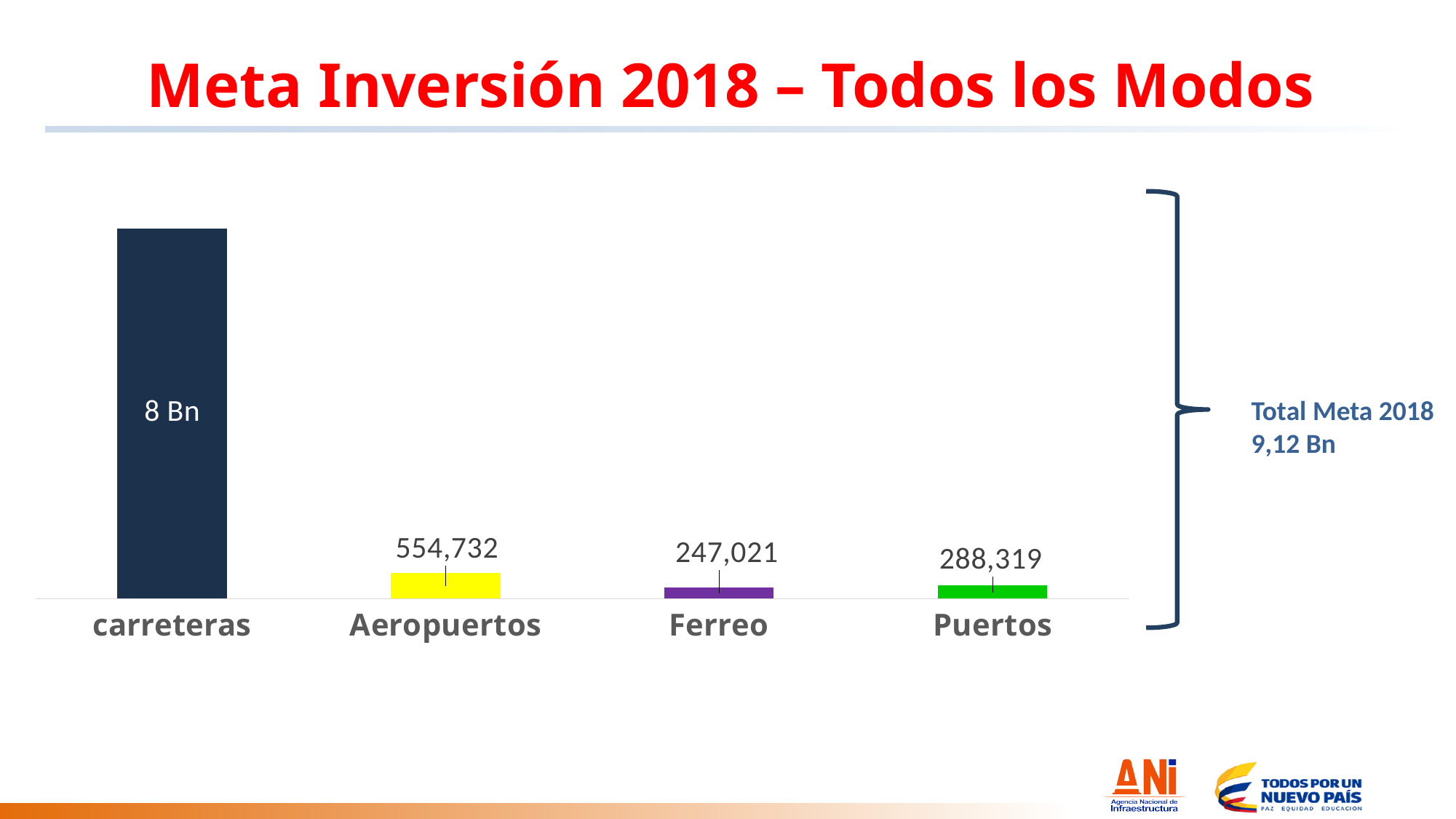
What is the value shown for carreteras? 8 Bn What is the Total Meta 2018 shown next to the chart? 9,12 Bn What is the value shown for Ferreo? 247,021 Which category has the highest value? carreteras What kind of chart is shown on the slide? Bar chart What is the difference between the values for Puertos and Ferreo? 41,298 What is the value shown for Puertos? 288,319 Which category has the lowest value? Ferreo How many categories are shown in the chart? 4 Which is larger, the value for Puertos or the value for Ferreo? Puertos What is the difference between the values for Aeropuertos and Puertos? 266,413 What is the value shown for Aeropuertos? 554,732